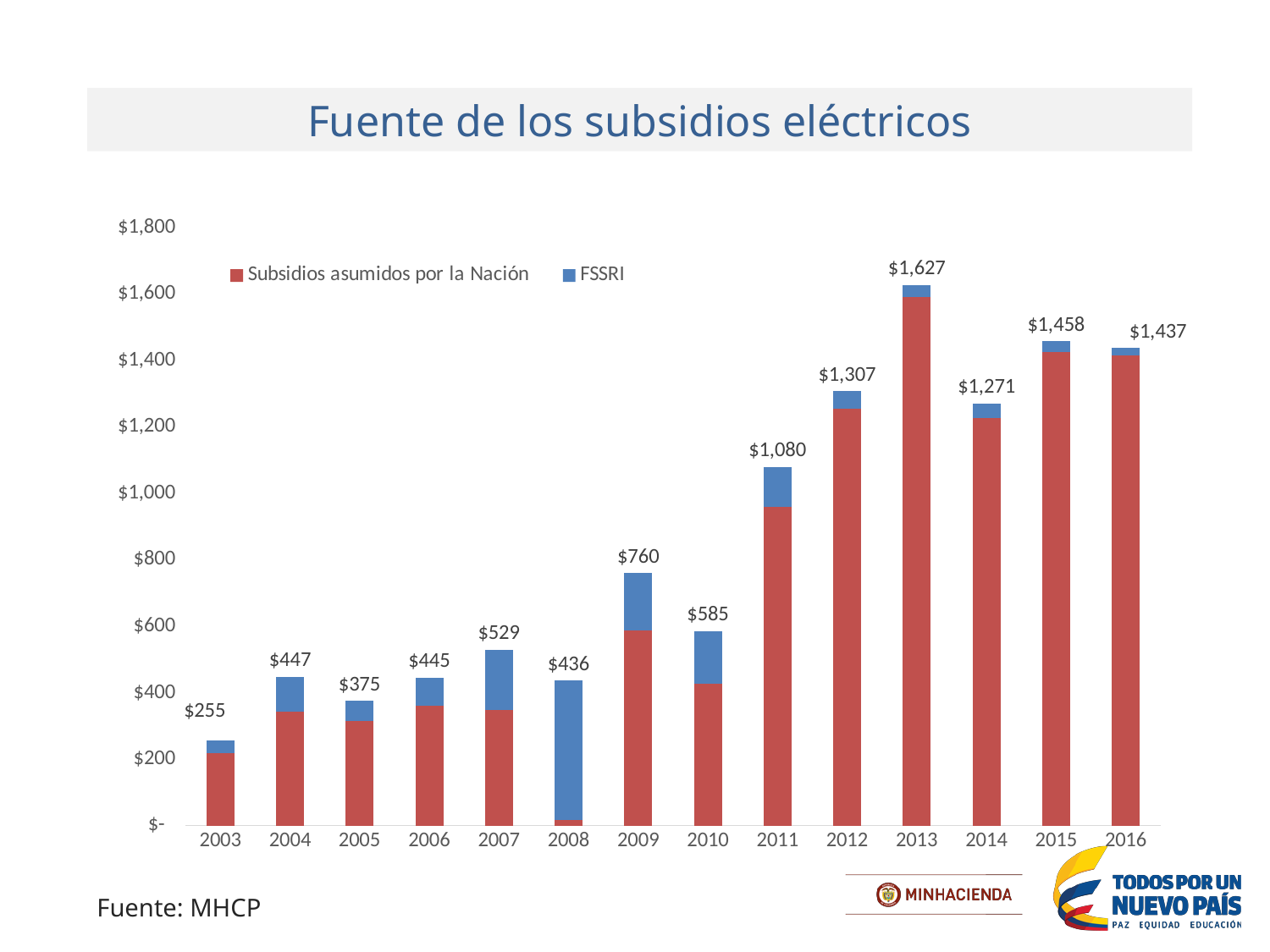
How many series does the legend list? 2 Is the 'Subsidios asumidos por la Nación' value for 2013 greater or less than $1,400? greater What is the total value of the bar for 2003? $255 How many years are shown on the x axis? 14 Is the 'Subsidios asumidos por la Nación' value for 2008 greater or less than $200? less What is the total value of the bar for 2010? $585 What is the total value of the bar for 2013? $1,627 What is the difference between the total for 2013 and the total for 2014? $356 Which year has the lowest total bar? 2003 Which year has the highest total bar? 2013 Which year has a larger total, 2015 or 2016? 2015 What type of chart is shown on the slide? Stacked bar chart